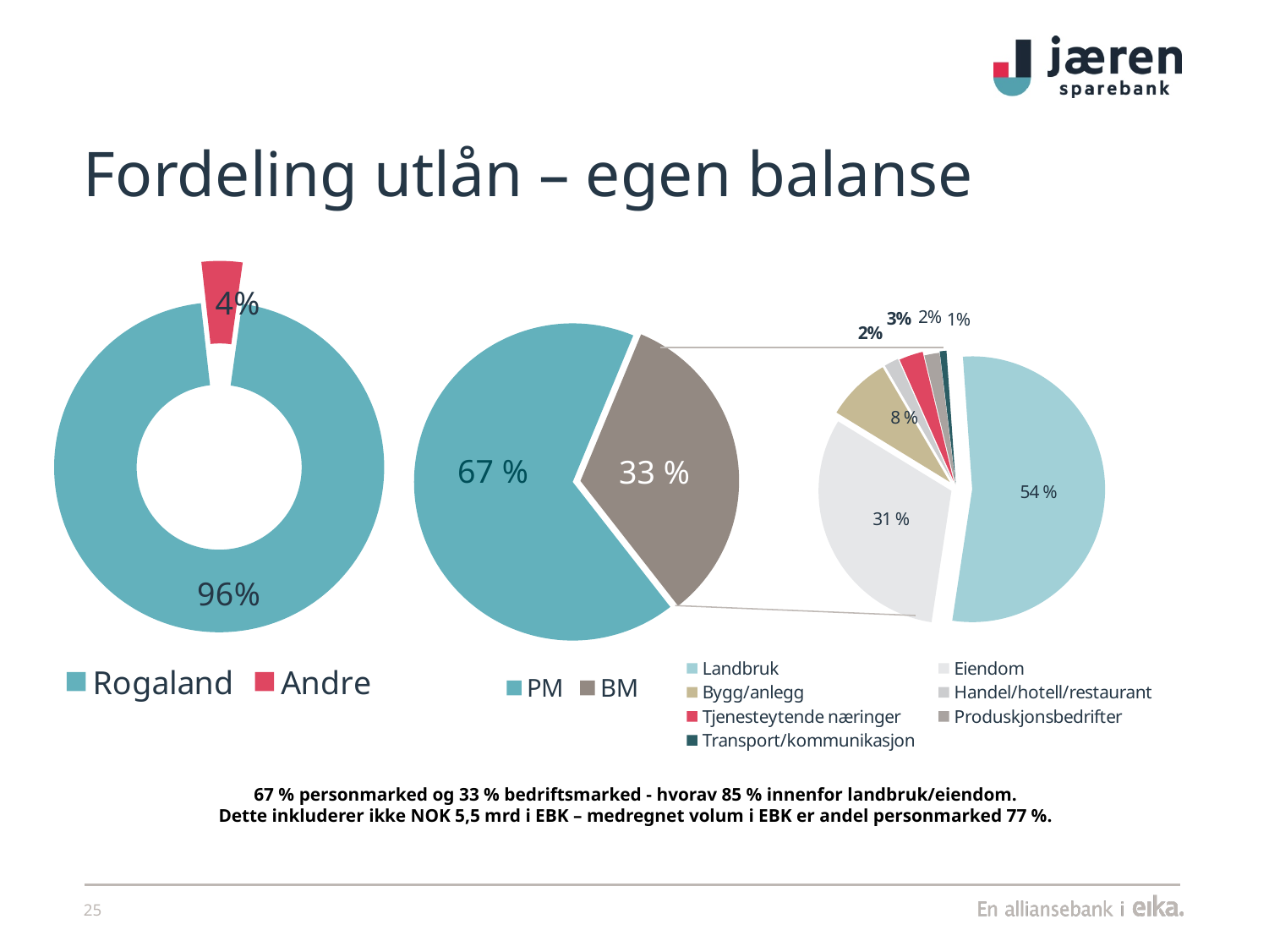
In the middle pie chart, what share is shown for BM? 33 % In the right-hand breakdown pie of the BM segment, what share is shown for Landbruk? 54 % In the middle pie chart, what share is shown for PM? 67 % In the right-hand breakdown pie of the BM segment, what share is shown for Eiendom? 31 % In the left donut chart, what share is shown for Rogaland? 96% In the right-hand breakdown pie of the BM segment, what share is shown for Bygg/anlegg? 8 % In the left donut chart, what is the difference between the Rogaland share and the Andre share? 92% What kind of chart is the left chart showing Rogaland and Andre? Donut (pie) chart In the middle pie chart, which is larger, PM or BM? PM In the right-hand breakdown pie of the BM segment, which category has the largest share? Landbruk How many categories does the legend of the right-hand breakdown pie list? 7 In the left donut chart, what share is shown for Andre? 4%